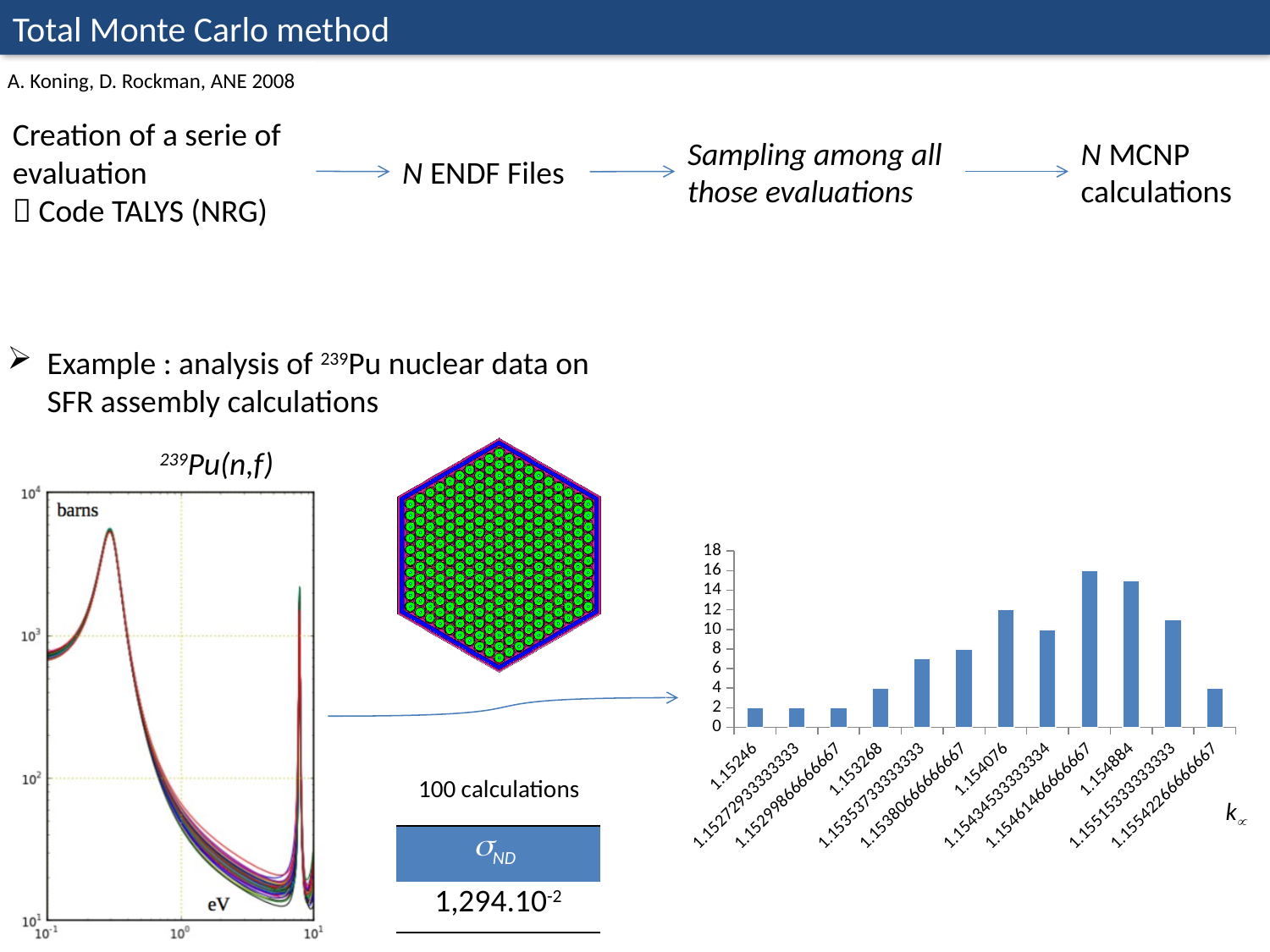
What is the title of the line chart on the left of the slide? 239Pu(n,f) In the bar chart on the right, how many bars (categories) are plotted? 12 What quantity is labelled on the x-axis of the bar chart on the right? k∞ In the bar chart on the right, which category has the highest bar? 1.15461466666667 In the bar chart on the right, which has the larger value: 1.154076 or 1.15434533333334? 1.154076 In the bar chart on the right, is the value for 1.15353733333333 greater or less than 6? greater In the bar chart on the right, what is the value for the category 1.154076? 12 What kind of chart is the chart on the right of the slide with the k∞ x-axis? bar chart In the bar chart on the right, what is the difference between the values for 1.15461466666667 and 1.154076? 4 In the bar chart on the right, what is the value for the category 1.15461466666667? 16 In the bar chart on the right, is the value for 1.15515333333333 greater or less than 10? greater In the bar chart on the right, what is the value for the category 1.15246? 2